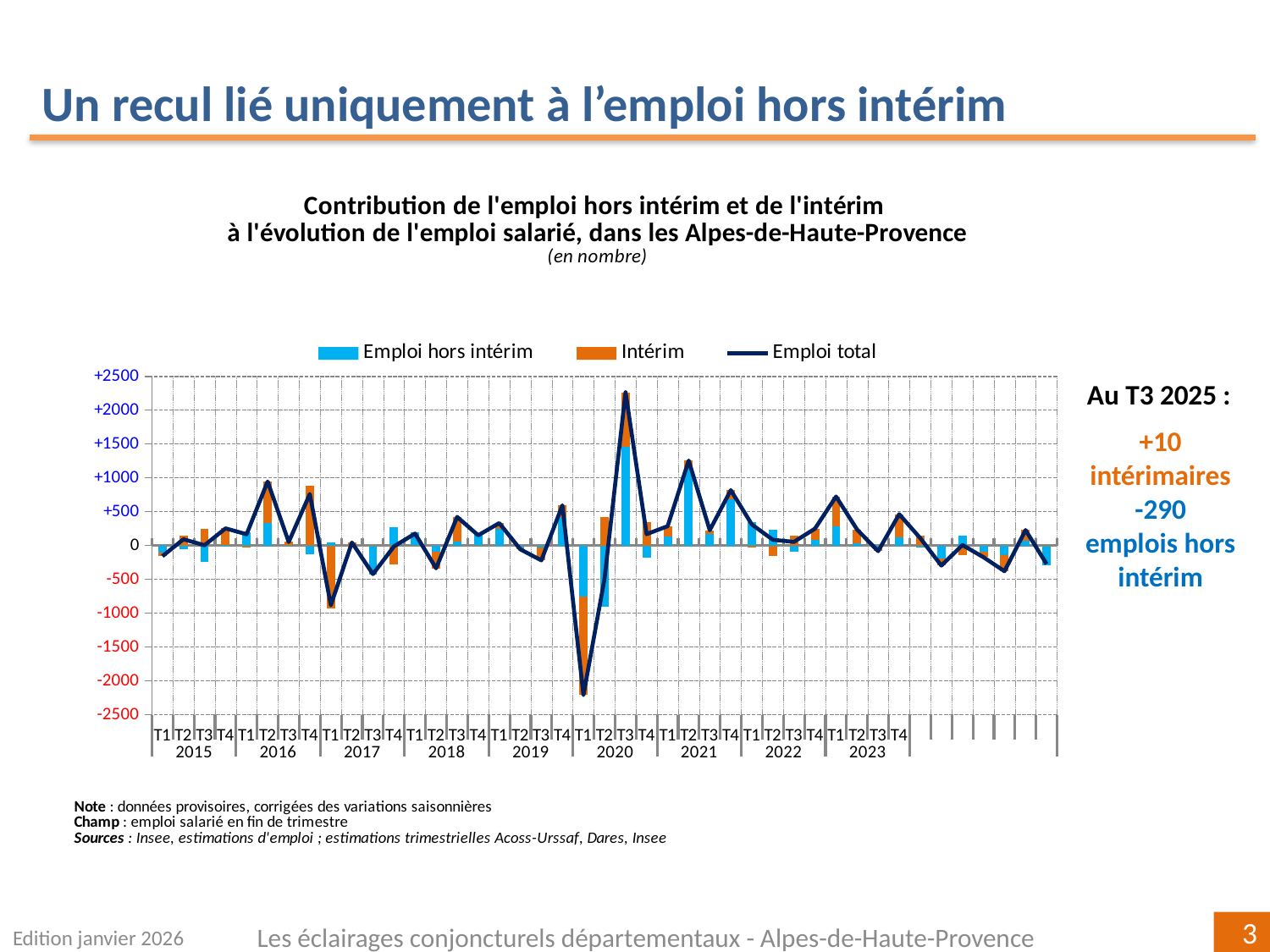
Is the Emploi total value for T1 2020 greater or less than -2000? less In which quarter does the Emploi total line reach its highest value? T3 2020 According to the text beside the chart, what is the contribution of intérimaires at T3 2025? +10 How many series does the chart legend list? 3 What colour are the bars for the Intérim series? Orange What type of chart is shown on the slide? A combined bar and line chart According to the text beside the chart, what is the contribution of emplois hors intérim at T3 2025? -290 Is the Emploi total value for T3 2020 greater or less than 2000? greater In which quarter does the Emploi total line reach its lowest value? T1 2020 Which series is drawn as a line rather than bars? Emploi total Which is larger, the Emploi total value for T3 2020 or for T2 2021? T3 2020 Is the Emploi total value for T1 2017 greater or less than -500? less